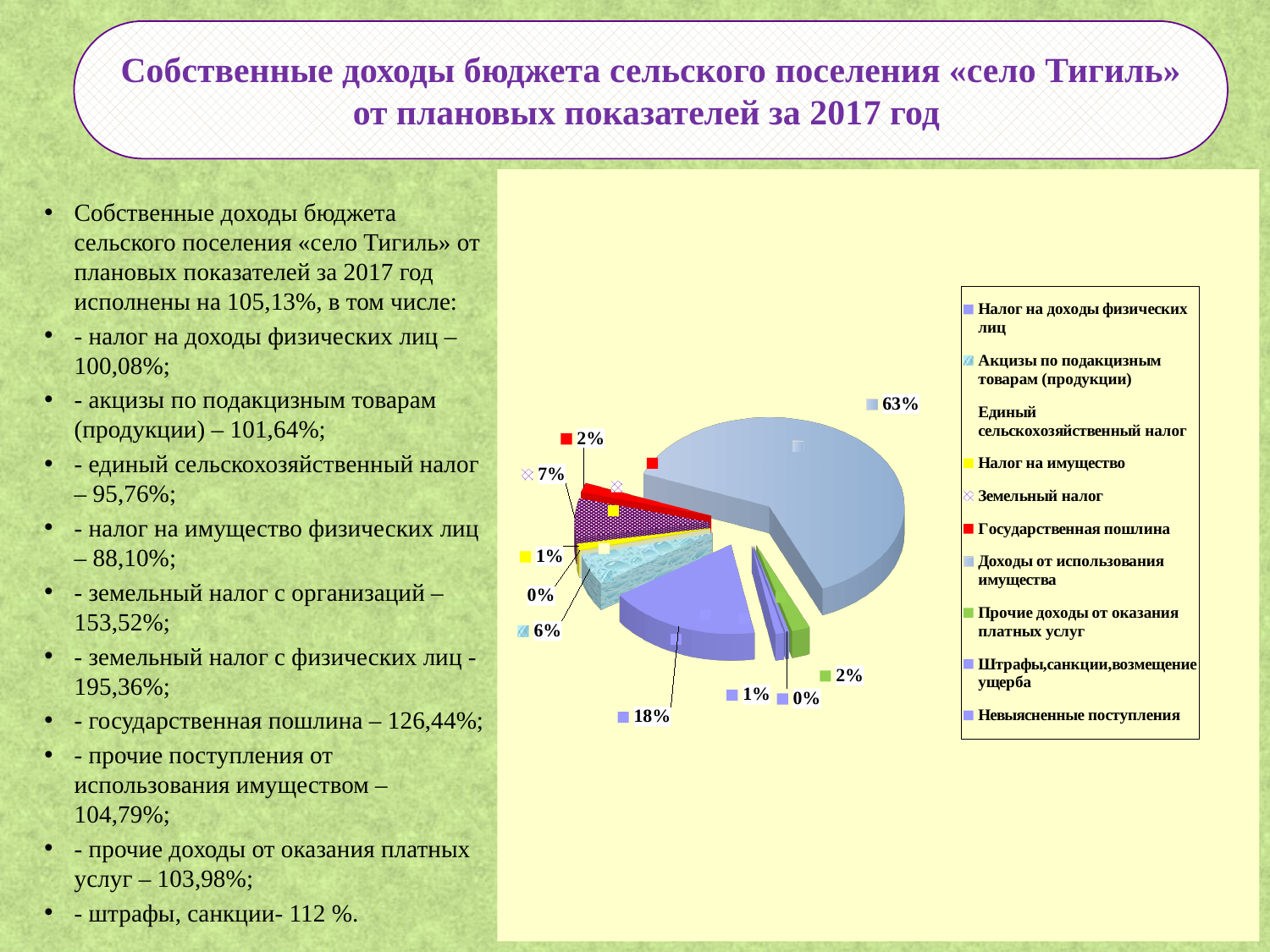
What is the difference between the largest slice (63%) and the 18% slice? 45% How many slices on the pie chart are labelled 0%? 2 Which is larger: the share for Земельный налог (7%) or the share for Акцизы по подакцизным товарам (6%)? Земельный налог What share is shown for the large purple slice (Налог на доходы физических лиц)? 18% What share is shown for the yellow slice (Налог на имущество)? 1% What share is shown for the green slice (Прочие доходы от оказания платных услуг)? 2% What share is shown for the cyan textured slice (Акцизы по подакцизным товарам)? 6% What share is shown for the purple textured slice (Земельный налог)? 7% What is the largest share shown on the pie chart? 63% What share is shown for the red slice (Государственная пошлина)? 2% How many entries does the legend of the pie chart list? 10 What kind of chart is shown on the slide? pie chart